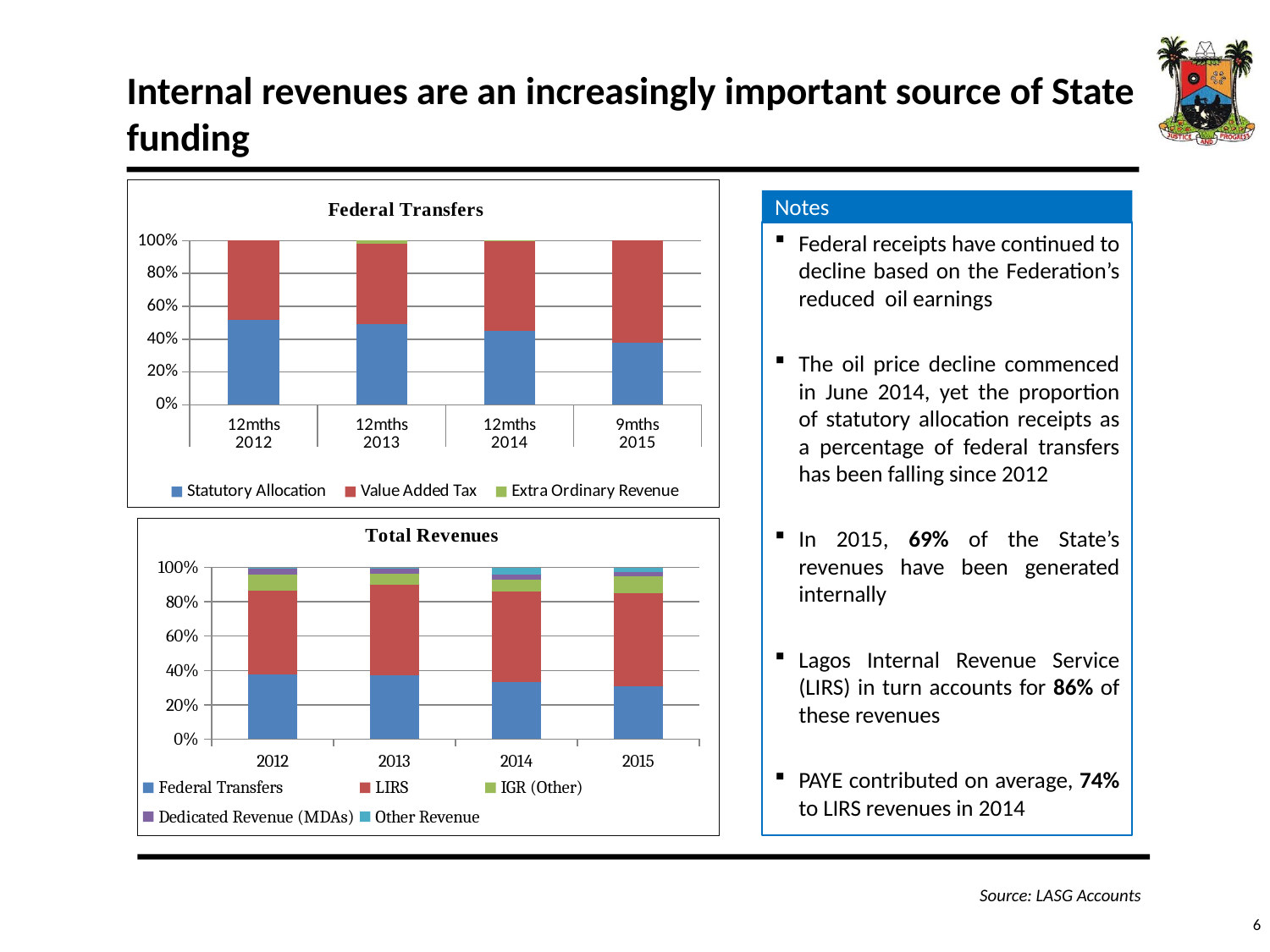
How many series does the legend of the Federal Transfers chart list? 3 In the Federal Transfers chart, is the Statutory Allocation share for 9mths 2015 greater or less than 60%? less In the Total Revenues chart, is the Federal Transfers share for 2015 greater or less than 40%? less How many categories are shown on the x axis of the Total Revenues chart? 4 In the Federal Transfers chart, is the Statutory Allocation share for 12mths 2012 greater or less than 40%? greater What type of chart is the Federal Transfers chart? stacked bar chart How many categories are shown on the x axis of the Federal Transfers chart? 4 In the Federal Transfers chart, which category has the lowest Statutory Allocation share? 9mths 2015 In the Total Revenues chart, which series is shown in red? LIRS In the Total Revenues chart, which is larger: the Federal Transfers share in 2012 or in 2015? 2012 How many series does the legend of the Total Revenues chart list? 5 In the Federal Transfers chart, does the Statutory Allocation share rise or fall from 12mths 2012 to 9mths 2015? fall